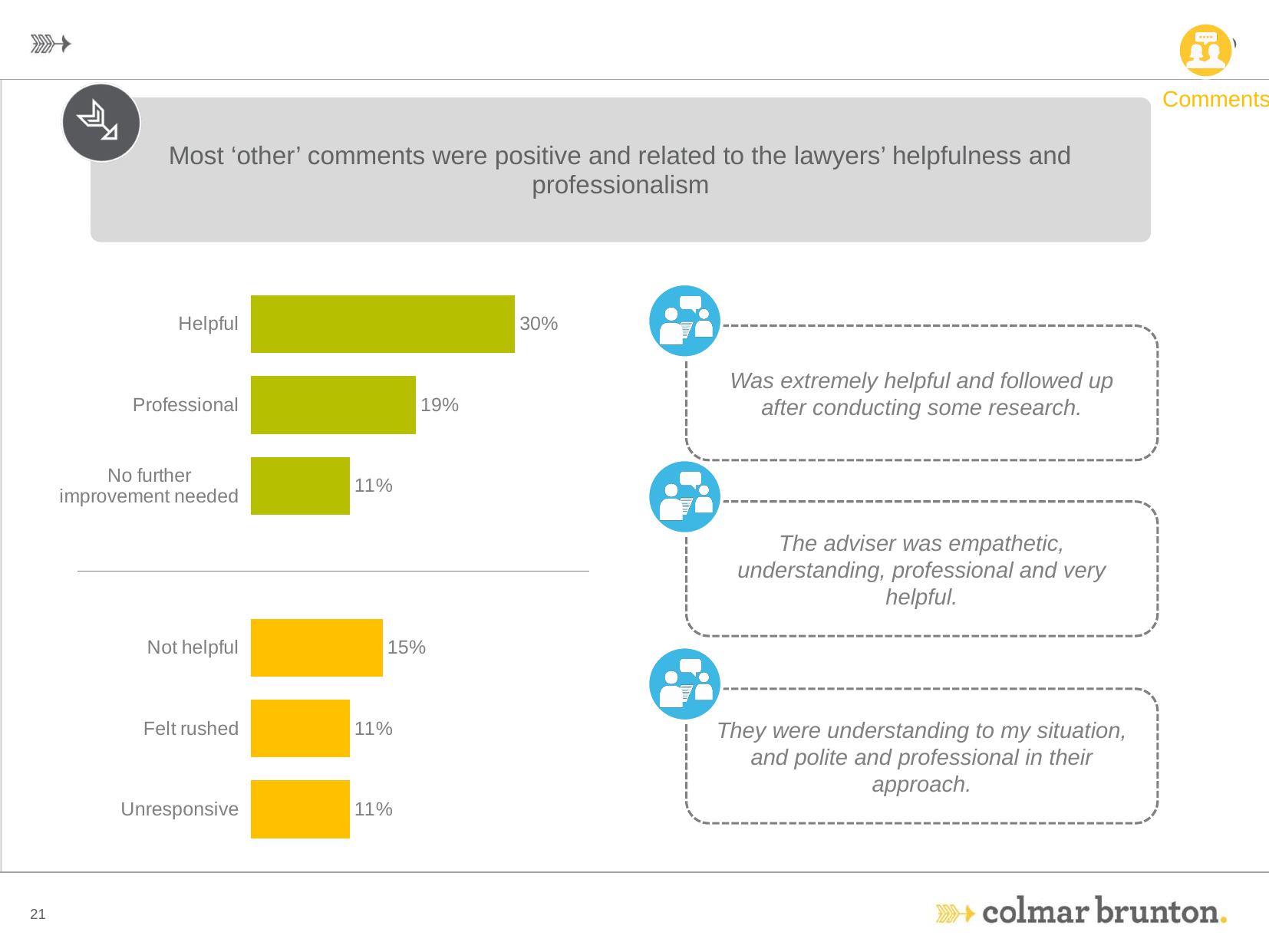
In the lower chart, what is the value for Not helpful? 15% Which is larger: the value for Professional in the upper chart or the value for Not helpful in the lower chart? Professional In the upper chart, which category has the highest value? Helpful What type of chart is the upper chart? Bar chart In the lower chart, what is the value for Felt rushed? 11% In the lower chart, what is the difference between the values for Not helpful and Unresponsive? 4% In the lower chart, which category has the highest value? Not helpful In the upper chart, what is the difference between the values for Helpful and Professional? 11% In the upper chart, what is the value for No further improvement needed? 11% How many categories are shown in the lower chart? 3 In the upper chart, what is the value for Helpful? 30% In the upper chart, what is the value for Professional? 19%